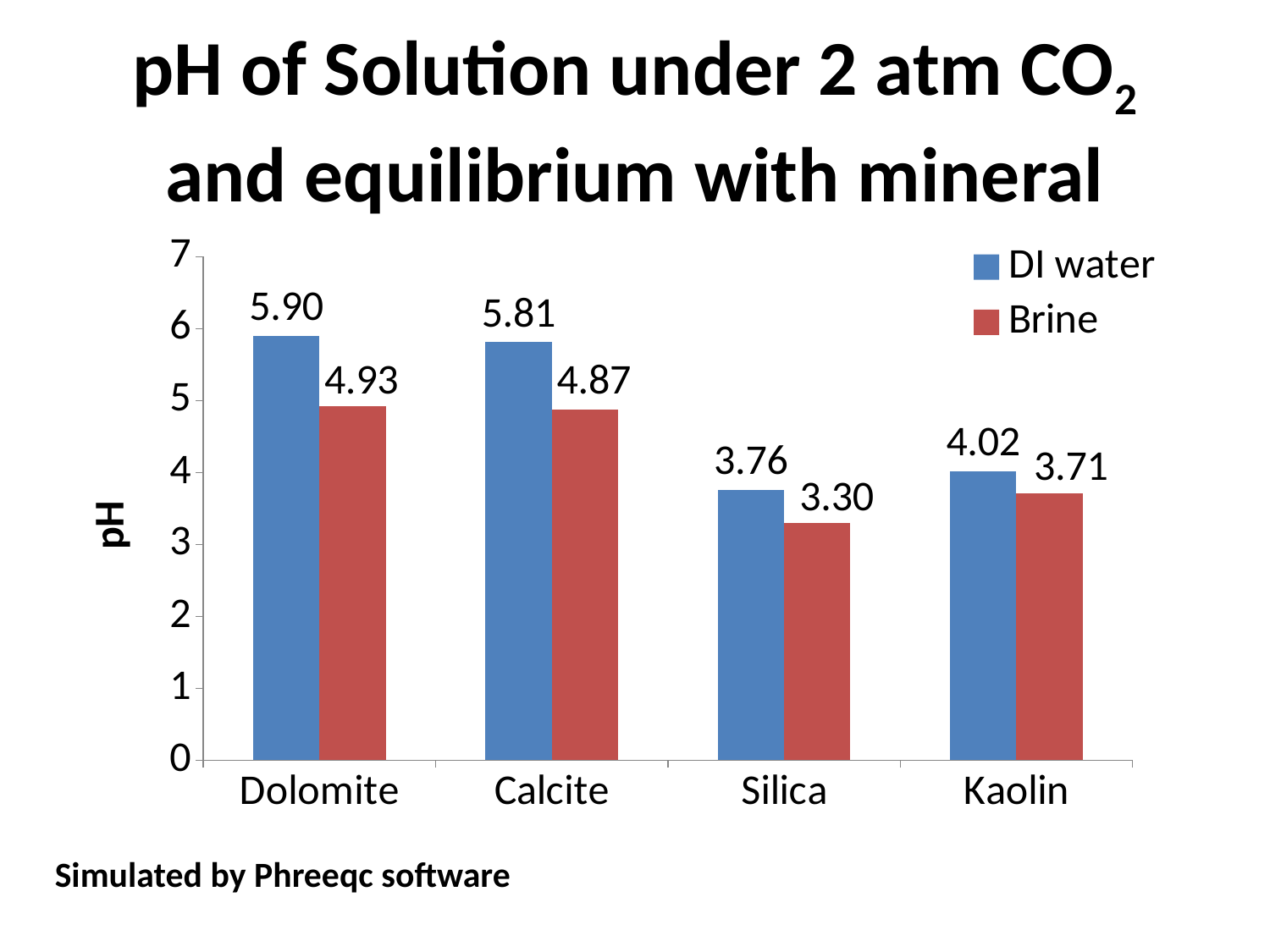
What is the pH for Silica in Brine? 3.30 How many series does the legend list? 2 What is the label of the y axis? pH How many minerals are shown on the x axis? 4 Which mineral has the lowest pH in Brine? Silica What is the pH for Dolomite in DI water? 5.90 Which is larger, the Brine pH for Dolomite or the Brine pH for Kaolin? Dolomite What is the pH for Kaolin in DI water? 4.02 Which colour represents the Brine series? Red What kind of chart is shown on the slide? Bar chart What is the difference between the DI water and Brine pH values for Calcite? 0.94 Which mineral has the highest pH in DI water? Dolomite